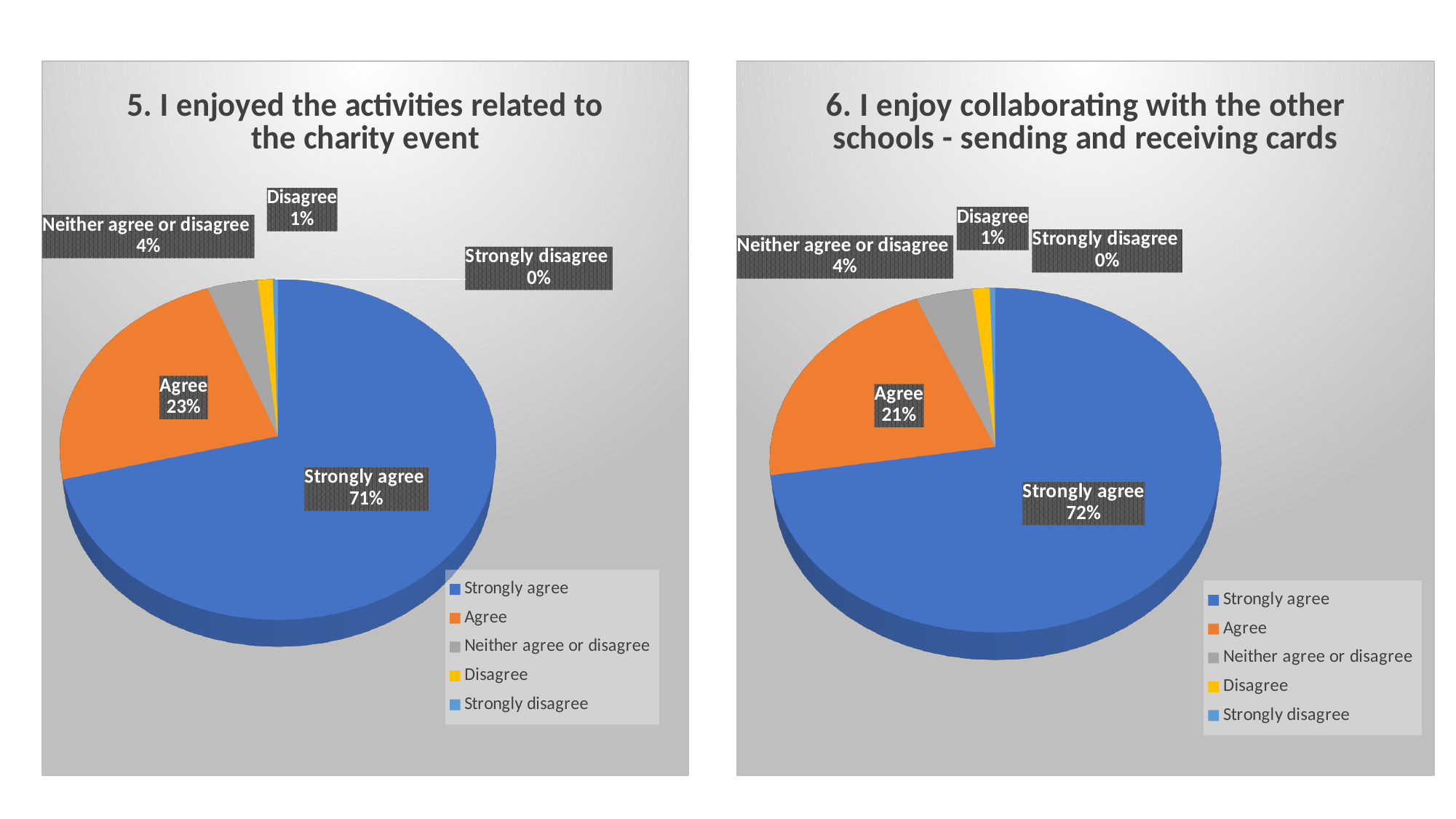
In the left chart, which category has the largest slice? Strongly agree In the chart titled "6. I enjoy collaborating with the other schools - sending and receiving cards", what percentage is shown for Neither agree or disagree? 4% In the right chart, which category has the smallest slice? Strongly disagree How many categories does the legend of the left chart list? 5 In the right chart, which is larger, Agree or Neither agree or disagree? Agree In the left chart, what is the difference in percentage points between Strongly agree and Agree? 48 In the chart titled "5. I enjoyed the activities related to the charity event", what percentage is shown for Agree? 23% In the chart titled "6. I enjoy collaborating with the other schools - sending and receiving cards", what percentage is shown for Strongly agree? 72% In the chart titled "5. I enjoyed the activities related to the charity event", what percentage is shown for Strongly agree? 71% In the left chart, what colour is the Agree slice? Orange In the right chart, what percentage is shown for Disagree? 1% What kind of chart is the chart titled "6. I enjoy collaborating with the other schools - sending and receiving cards"? Pie chart